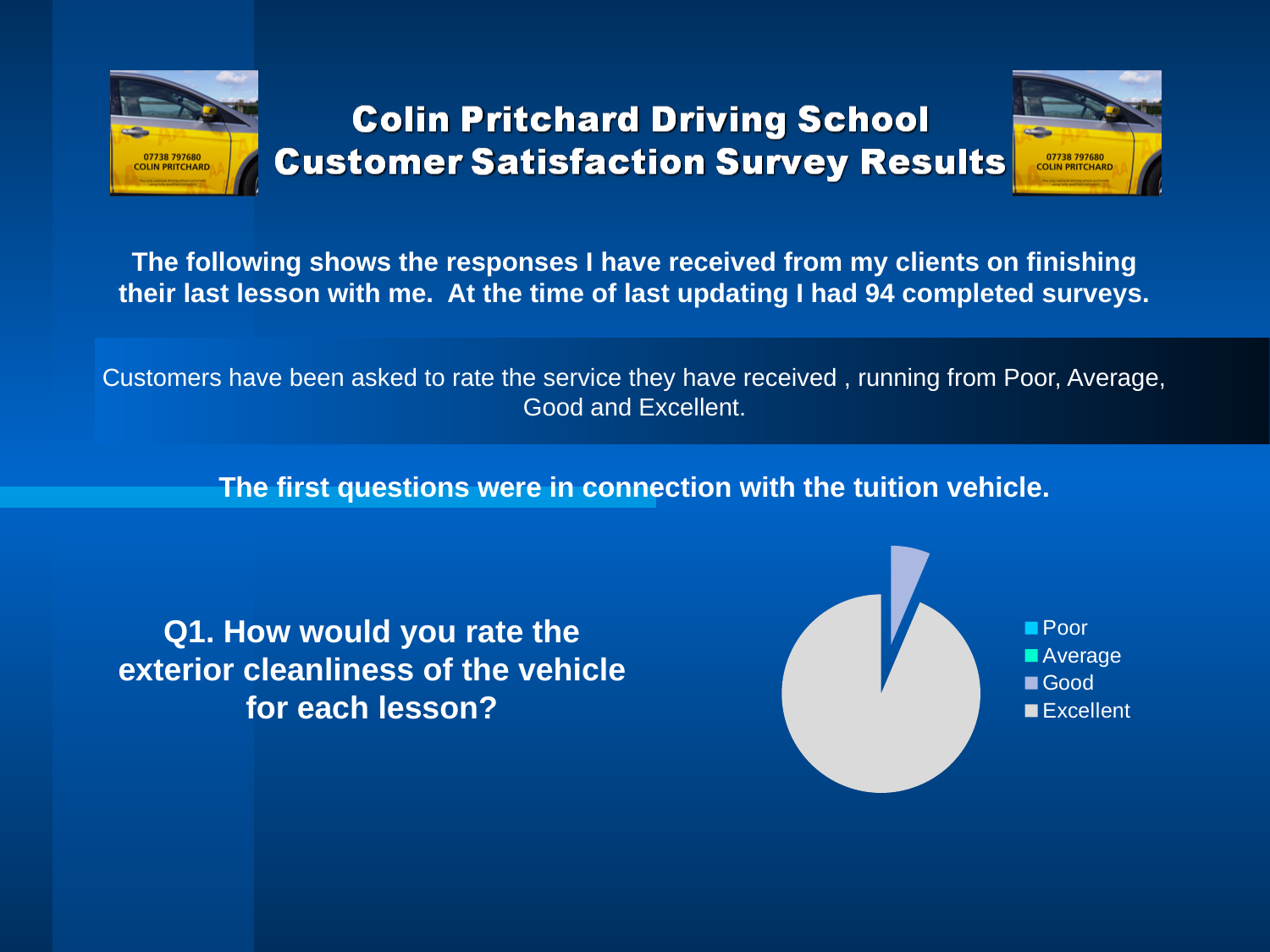
What kind of chart is shown on the slide? Pie chart Which rating categories are listed in the pie chart's legend? Poor, Average, Good, Excellent Which survey question does the pie chart show the results for? Q1. How would you rate the exterior cleanliness of the vehicle for each lesson? Which category is listed first in the pie chart's legend? Poor Does the Excellent slice take up more or less than half of the pie chart? More How many categories does the pie chart's legend list? 4 Which category has the largest slice of the pie chart? Excellent Which is larger in the pie chart, the slice for Good or the slice for Excellent? Excellent